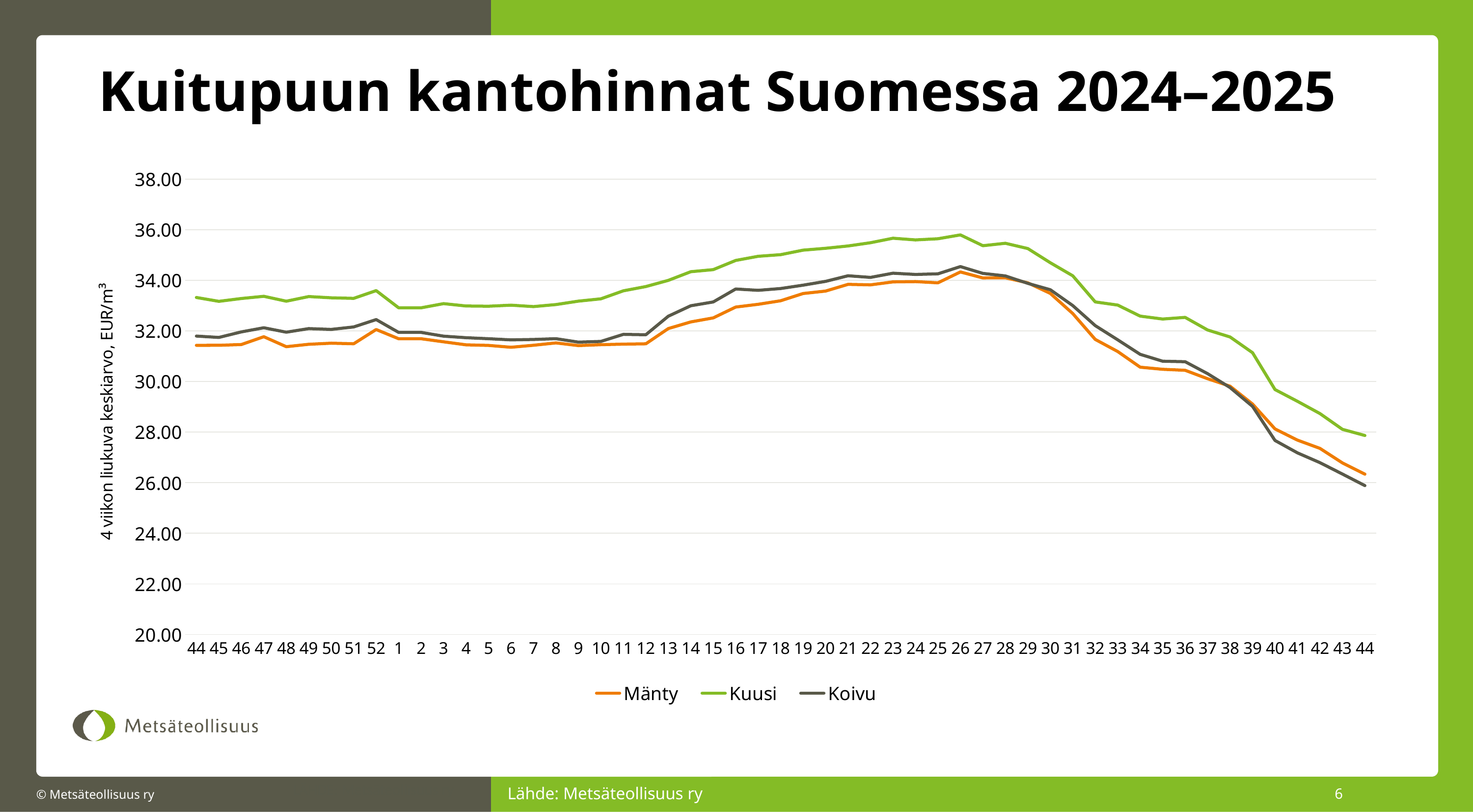
At week 16, which is larger, Koivu or Mänty? Koivu Is the value for Mänty at the last week 44 greater or less than 28.00? less Is the value for Kuusi at week 26 greater or less than 34.00? greater At week 26, which is larger, Kuusi or Mänty? Kuusi Do the values for all three series rise or fall from week 26 to the last week 44? fall How many series does the legend list? 3 Is the value for Koivu at the last week 44 greater or less than 28.00? less What kind of chart is shown on the slide? line chart What is the title of the chart? Kuitupuun kantohinnat Suomessa 2024–2025 Which series has the highest values across the whole chart? Kuusi Which series are listed in the legend? Mänty, Kuusi, Koivu